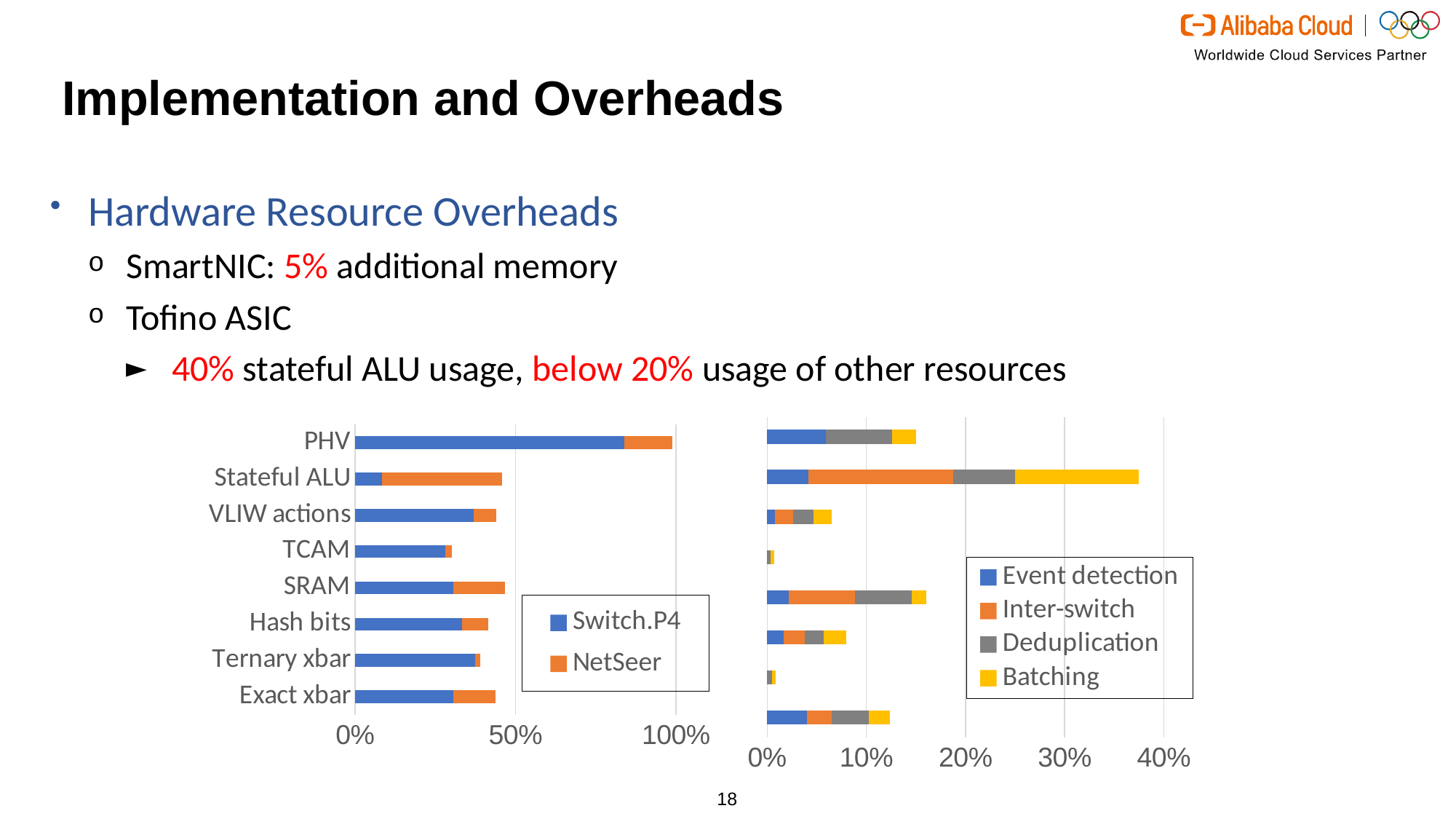
In the left chart, which category has the largest NetSeer segment? Stateful ALU How many series does the legend of the left chart list? 2 In the left chart, which category has the shortest total bar? TCAM In the left chart, which category has the longest total bar? PHV In the left chart, is the total bar for TCAM greater or less than 50%? less What are the legend entries of the right chart? Event detection, Inter-switch, Deduplication, Batching How many resource categories are shown on the left chart? 8 In the left chart, is the total bar for PHV greater or less than 50%? greater What kind of chart is the left chart on the slide? Stacked bar chart How many series does the legend of the right chart list? 4 In the left chart, which is larger: the Switch.P4 segment for PHV or the Switch.P4 segment for Stateful ALU? PHV In the right chart, is the longest bar greater or less than 30%? greater